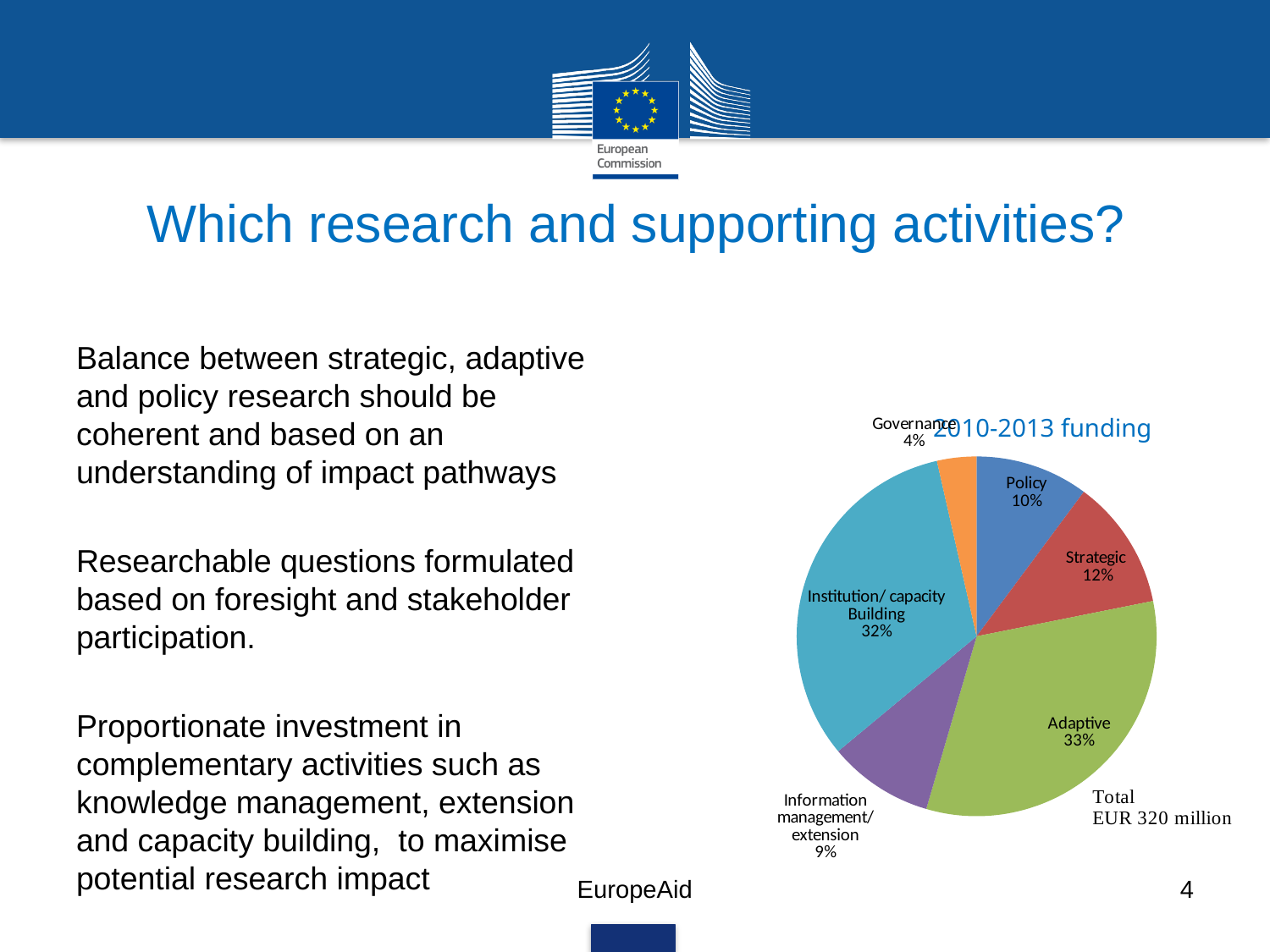
Which category received the smallest share of the 2010-2013 funding? Governance What share of the 2010-2013 funding went to Adaptive? 33% Which received a larger share of funding, Strategic or Information management/ extension? Strategic What share of the 2010-2013 funding went to Information management/ extension? 9% What is the difference in percentage points between the Strategic and Policy shares? 2 Which category received the largest share of the 2010-2013 funding? Adaptive What total funding amount is noted next to the pie chart? EUR 320 million What is the title of the pie chart? 2010-2013 funding What share of the 2010-2013 funding went to Governance? 4% How many slices does the pie chart have? 6 What share of the 2010-2013 funding went to Institution/ capacity Building? 32% What kind of chart is shown on the slide? pie chart